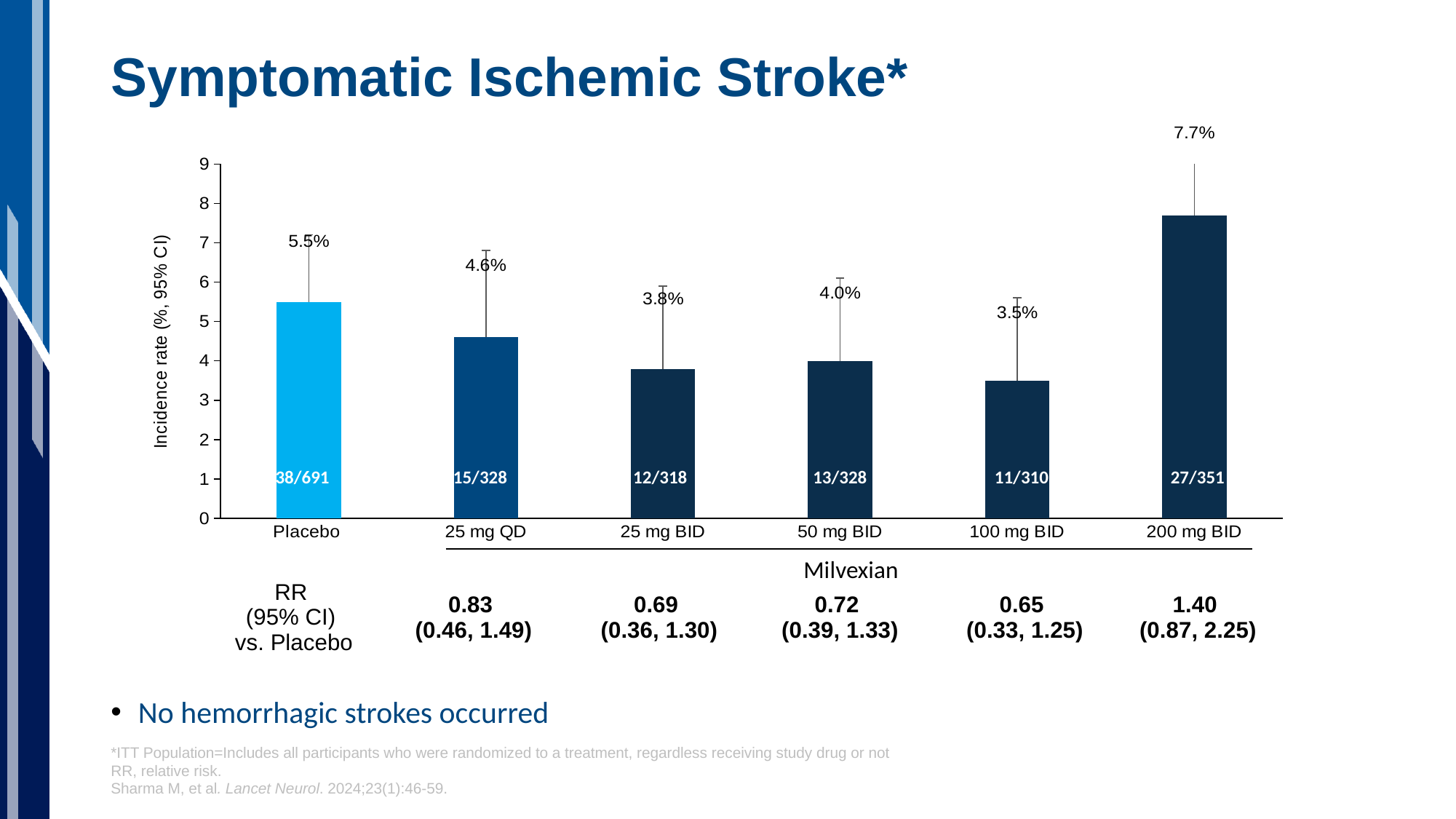
What is the incidence rate for the 100 mg BID group? 3.5% Which group has the highest incidence rate? 200 mg BID Which group has the lowest incidence rate? 100 mg BID Is the incidence rate for the 25 mg BID group greater or less than 5? less What is the y-axis label of the chart? Incidence rate (%, 95% CI) Which has a higher incidence rate, 25 mg QD or 50 mg BID? 25 mg QD What is the difference in incidence rate between the 200 mg BID group and Placebo? 2.2% How many treatment groups are shown on the x axis? 6 What event count is printed on the 25 mg BID bar? 12/318 What is the incidence rate for Placebo? 5.5% What kind of chart is shown on the slide? Bar chart What is the incidence rate for the 200 mg BID group? 7.7%